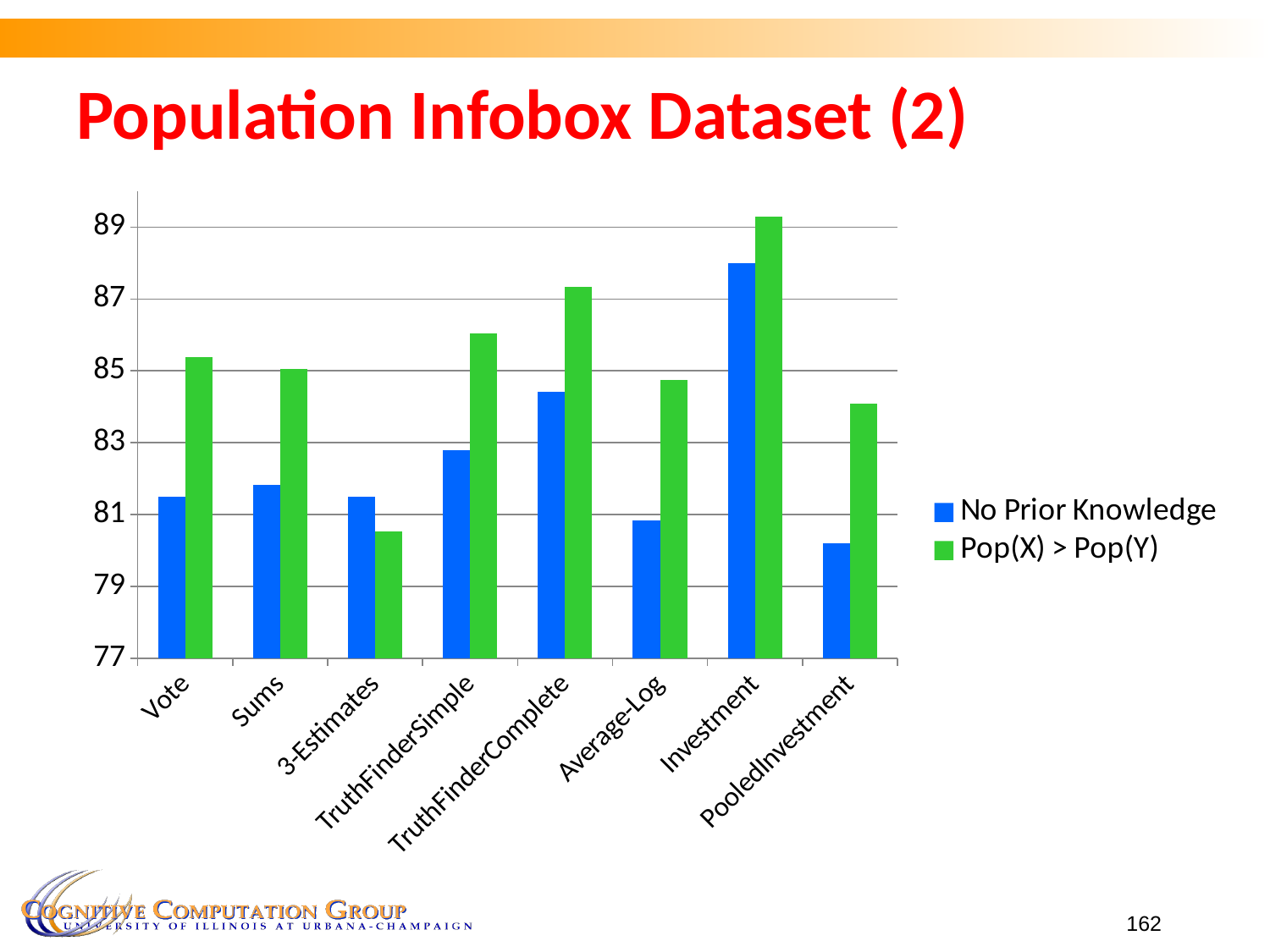
Which category has the lowest value for the Pop(X) > Pop(Y) series? 3-Estimates Is the Pop(X) > Pop(Y) value for TruthFinderComplete greater or less than 87? greater Which category has the highest value for the No Prior Knowledge series? Investment What kind of chart is shown on the slide? bar chart Is the No Prior Knowledge value for Investment greater or less than 87? greater For Vote, which series has the larger value: No Prior Knowledge or Pop(X) > Pop(Y)? Pop(X) > Pop(Y) For 3-Estimates, which series has the larger value: No Prior Knowledge or Pop(X) > Pop(Y)? No Prior Knowledge How many categories are shown on the x axis of the chart? 8 How many series does the chart's legend list? 2 Which category has the highest value for the Pop(X) > Pop(Y) series? Investment What colour represents the Pop(X) > Pop(Y) series in the chart? green Is the Pop(X) > Pop(Y) value for 3-Estimates greater or less than 81? less